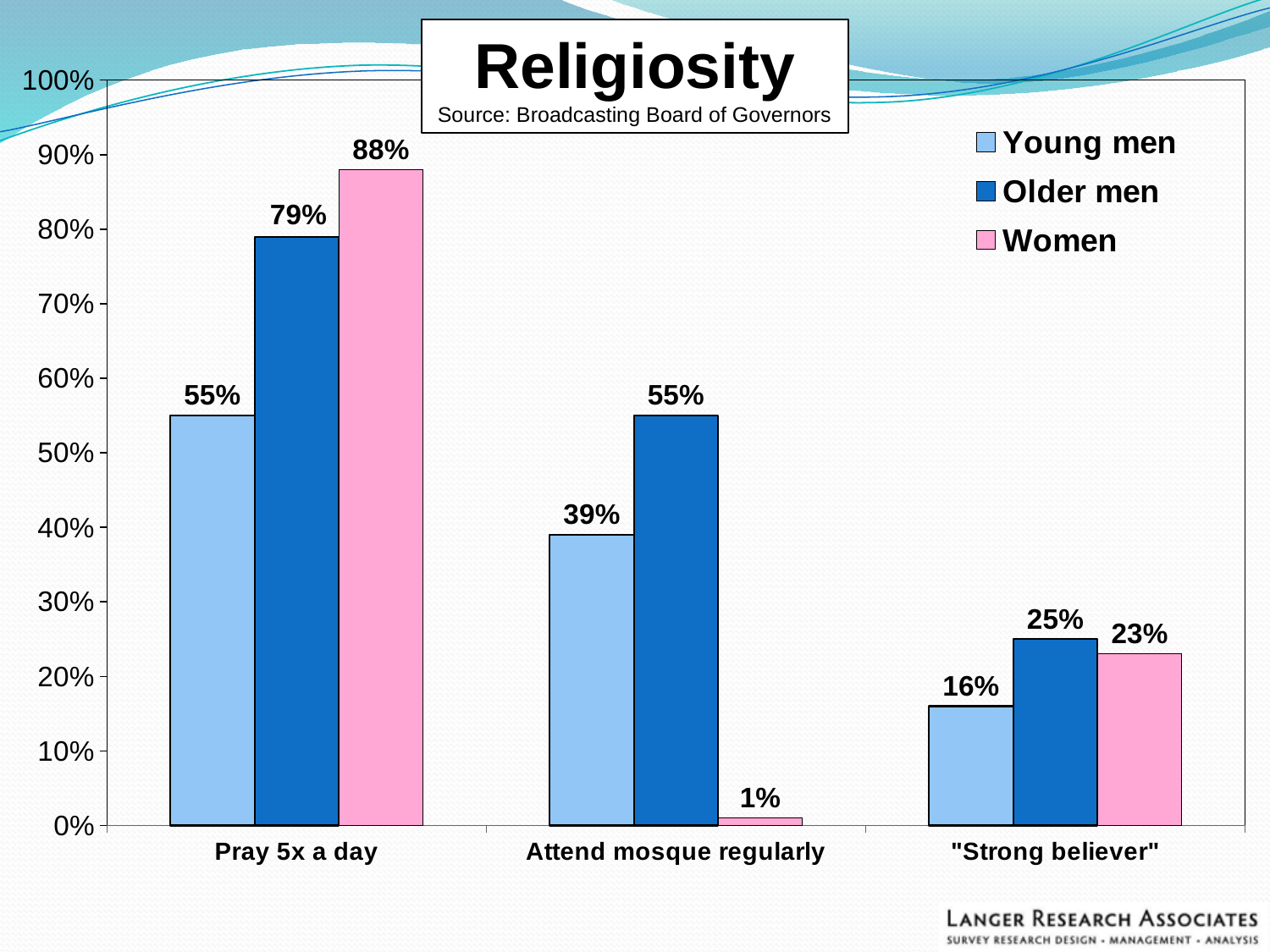
What is the source cited for the chart? Broadcasting Board of Governors Which group has the lowest value for "Attend mosque regularly"? Women Is the value for young men in "Attend mosque regularly" greater or less than 40%? less How many series does the legend list? 3 How many categories are shown on the x axis? 3 Which group has the highest value for "Pray 5x a day"? Women What percentage of young men are "Strong believer"? 16% Which is larger: the value for older men or for women in the "Strong believer" category? Older men What percentage of women pray 5x a day? 88% What kind of chart is shown on the slide? Bar chart What is the value for older men in the "Attend mosque regularly" category? 55% What is the difference between older men and young men for "Pray 5x a day"? 24%